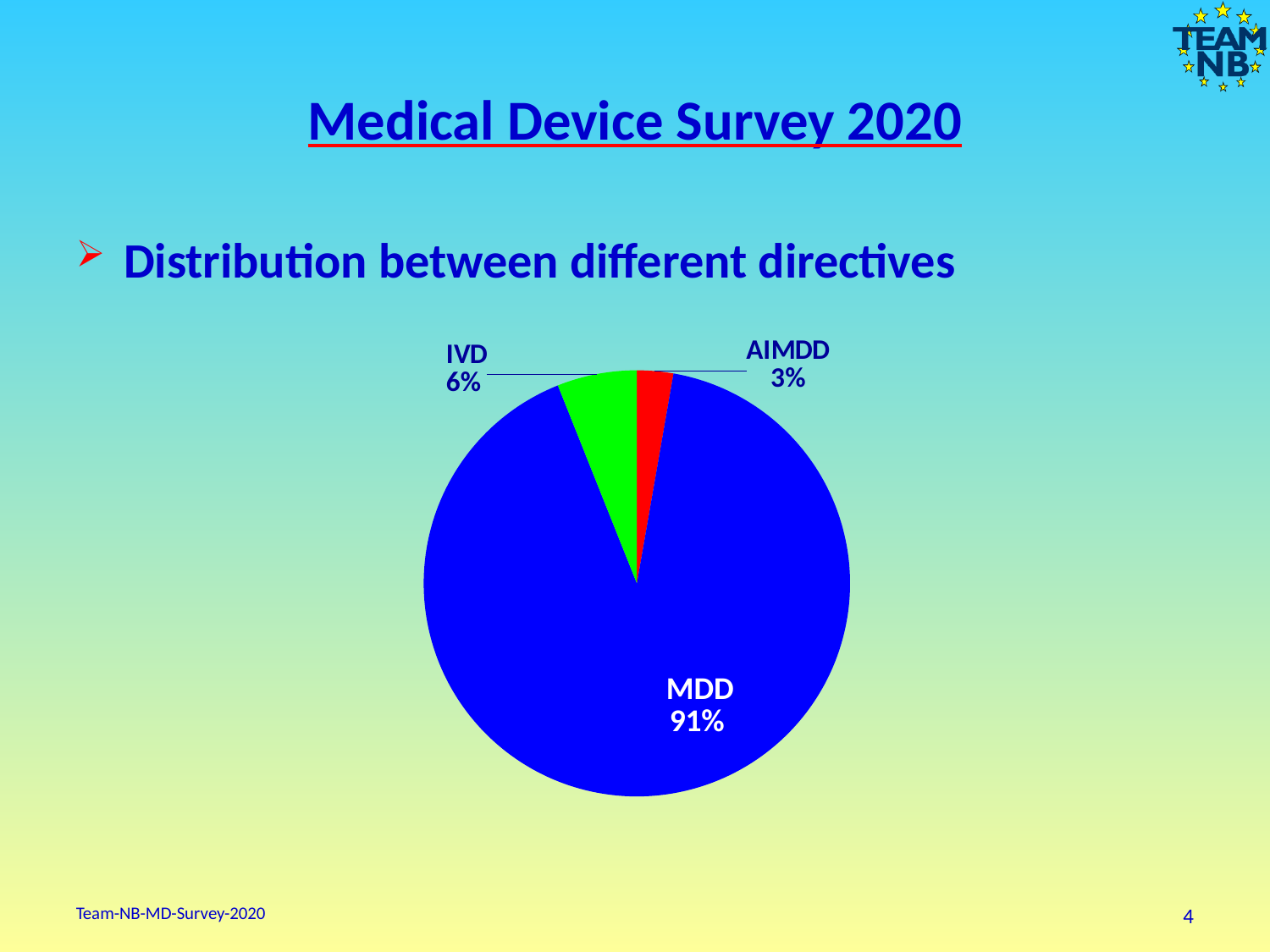
What is the difference in percentage points between the MDD and IVD slices? 85 What share of the pie does AIMDD represent? 3% Which slice is larger, IVD or AIMDD? IVD What share of the pie does IVD represent? 6% What colour is the MDD slice of the pie? blue Which directive has the largest slice of the pie? MDD How many slices does the pie chart have? 3 What colour is the IVD slice of the pie? green What share of the pie does MDD represent? 91% What kind of chart is shown on the slide? pie chart What is the difference in percentage points between the IVD and AIMDD slices? 3 Which directive has the smallest slice of the pie? AIMDD